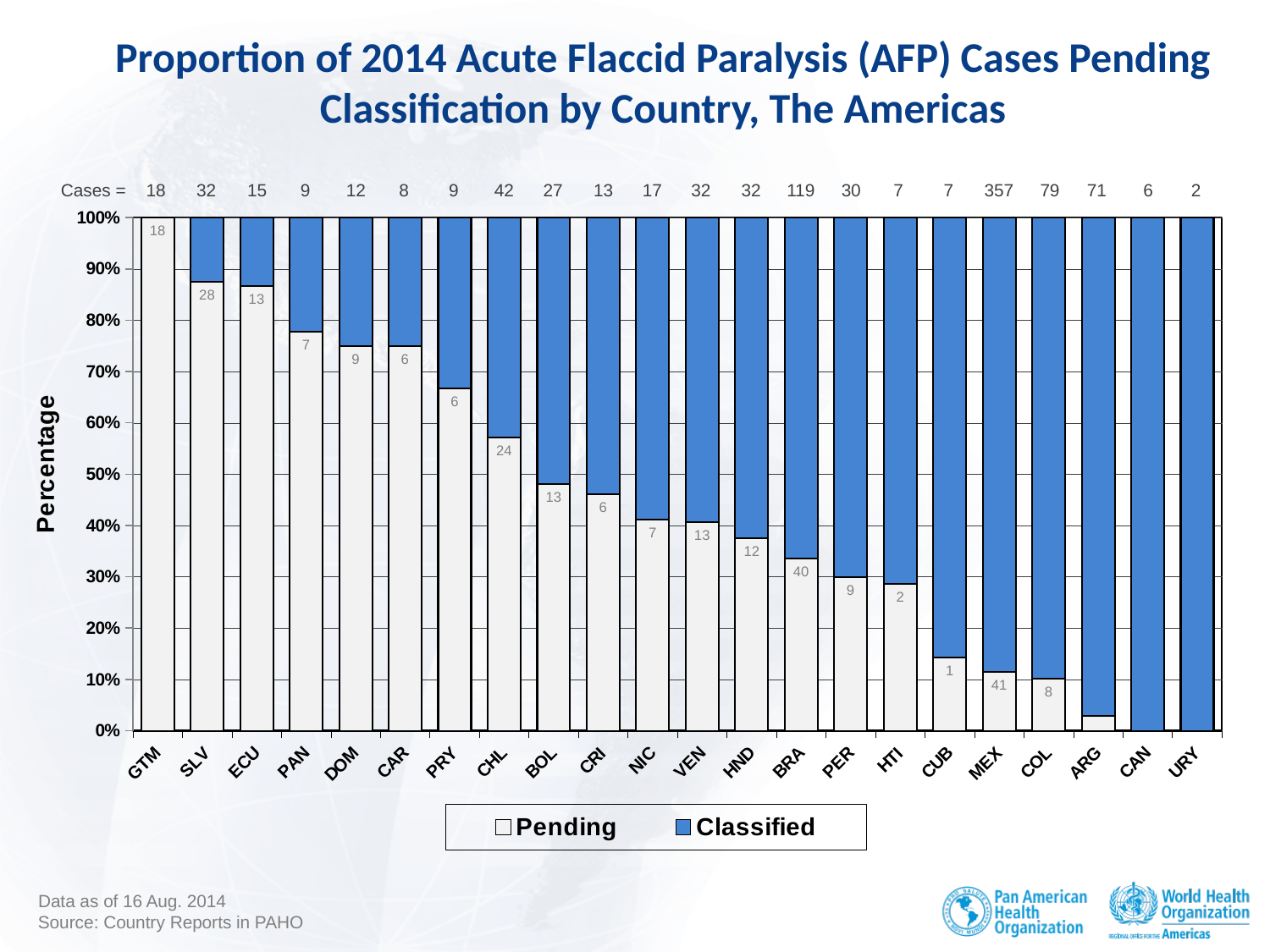
Moving from GTM on the left to URY on the right, does the pending percentage rise or fall? Fall What is the number of pending cases labelled on the bar for BRA? 40 Is the pending percentage for PRY greater or less than 60%? greater Which has more pending cases labelled on its bar, CHL or BOL? CHL How many countries are shown along the x axis? 22 Which country has the highest number of cases in the 'Cases =' row? MEX How many series does the legend list? 2 Which country has the lowest number of cases in the 'Cases =' row? URY What is the difference between the number of cases for MEX and BRA in the 'Cases =' row? 238 According to the 'Cases =' row, how many AFP cases does MEX have? 357 What kind of chart is shown on the slide? Stacked bar chart What is the number of pending cases labelled on the bar for SLV? 28